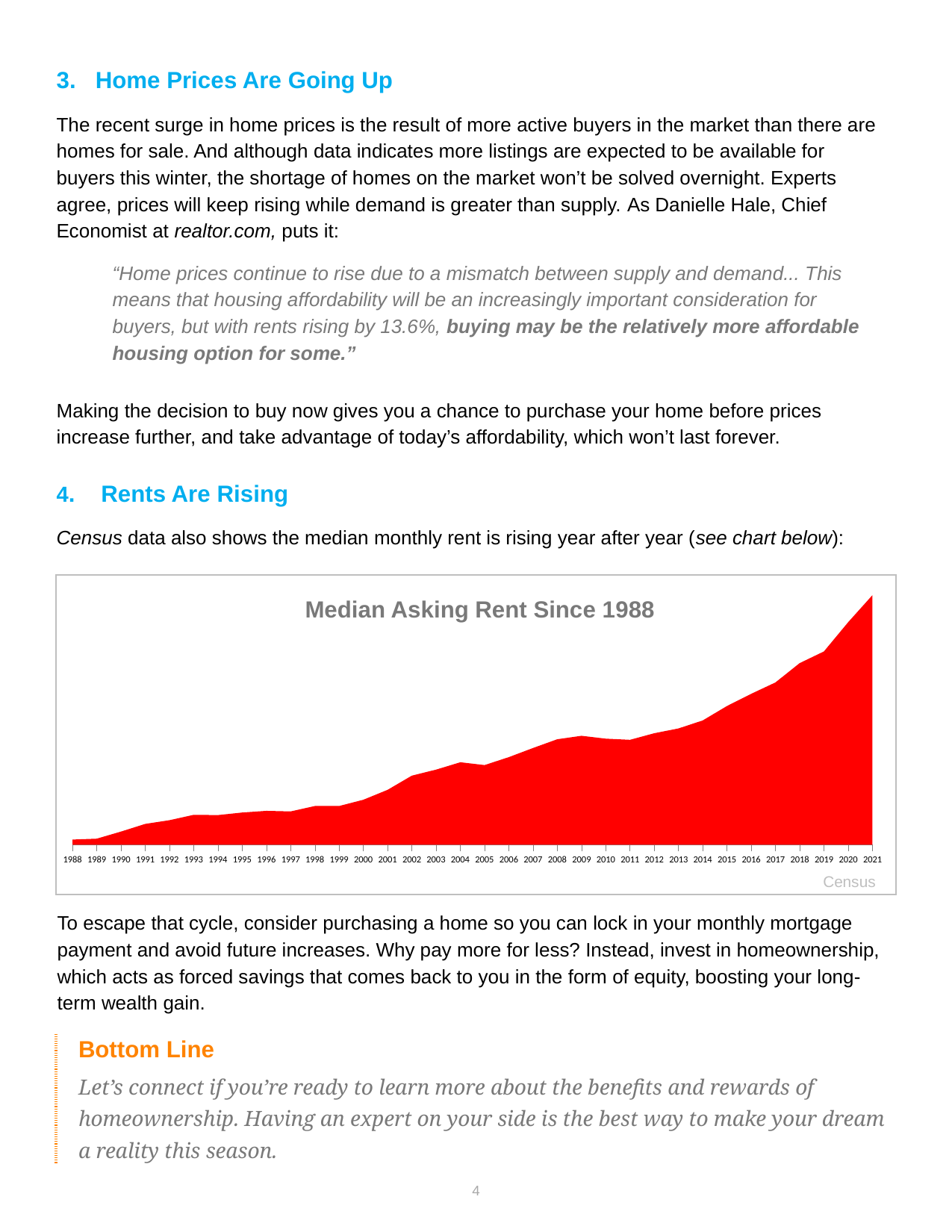
What is the title of the chart on the slide? Median Asking Rent Since 1988 Is the median asking rent higher in 2019 or in 2010? 2019 Do the values in the Median Asking Rent chart generally rise or fall from 1988 to 2021? Rise What is the first year shown on the x axis of the chart? 1988 What kind of chart is shown on the slide? Area chart How many years are shown along the x axis of the Median Asking Rent chart? 34 What is the last year shown on the x axis of the chart? 2021 Is the median asking rent higher in 2021 or in 1988? 2021 Is the median asking rent higher in 2008 or in 2000? 2008 What source is cited in the bottom right corner of the chart? Census Which year has the lowest median asking rent in the chart? 1988 Which year has the highest median asking rent in the chart? 2021